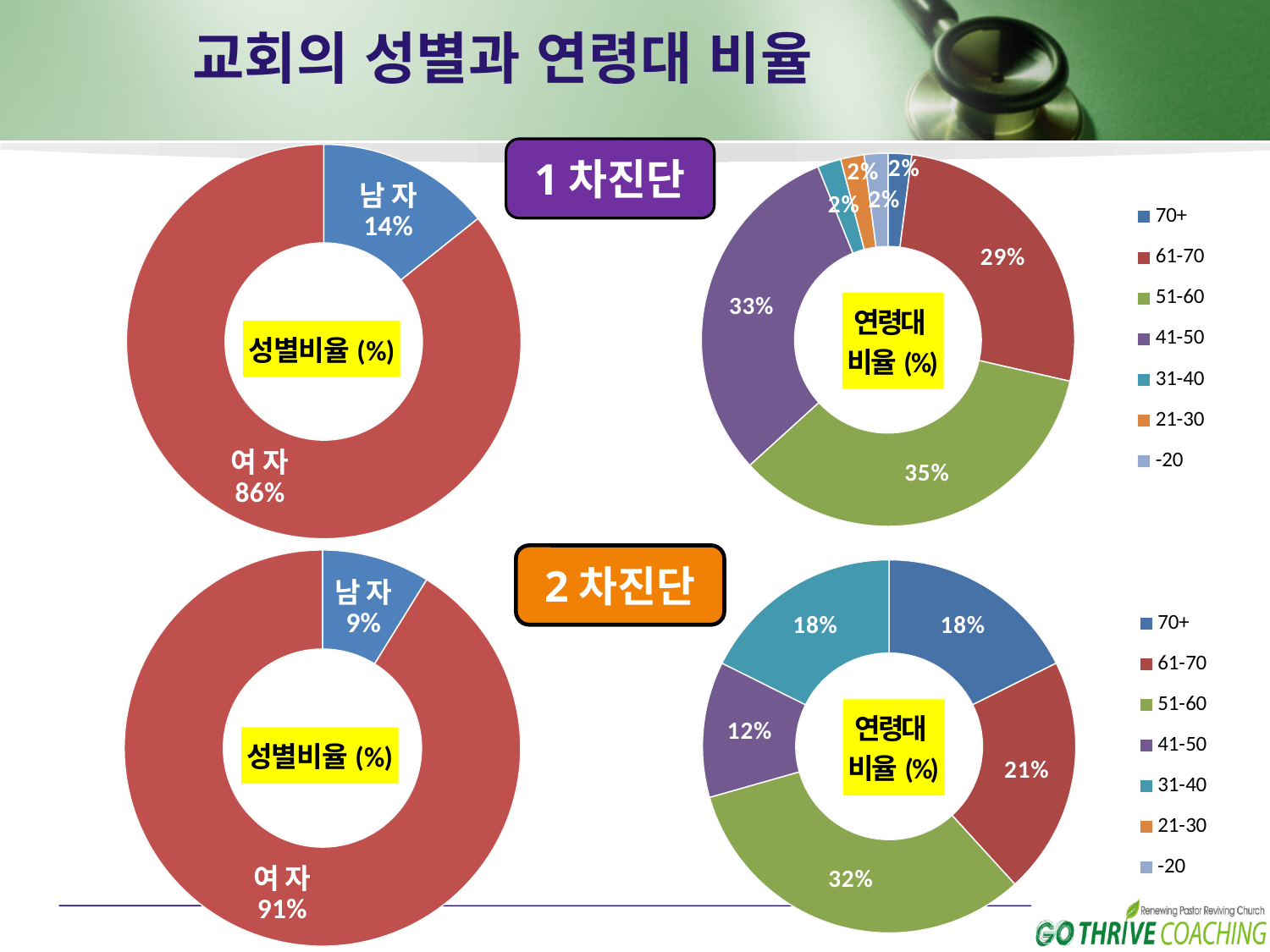
In the bottom-right 연령대 비율 (%) chart (2차진단), which age group has the largest share? 51-60 In the top-right 연령대 비율 (%) chart (1차진단), which age group has the largest share? 51-60 What kind of chart is the top-left 성별비율 (%) chart? Doughnut chart In the bottom-left 성별비율 (%) chart (2차진단), what is the value for 남자? 9% In the bottom-right 연령대 비율 (%) chart (2차진단), which is larger, 61-70 or 70+? 61-70 In the top-right 연령대 비율 (%) chart (1차진단), what is the value for 41-50? 33% In the bottom-left 성별비율 (%) chart (2차진단), what is the difference between 여자 and 남자? 82% In the top-left 성별비율 (%) chart (1차진단), what is the value for 남자? 14% In the top-left 성별비율 (%) chart (1차진단), what is the value for 여자? 86% How many entries does the legend of the top-right 연령대 비율 (%) chart list? 7 In the top-right 연령대 비율 (%) chart (1차진단), what is the value for 61-70? 29% In the bottom-right 연령대 비율 (%) chart (2차진단), what is the value for 41-50? 12%